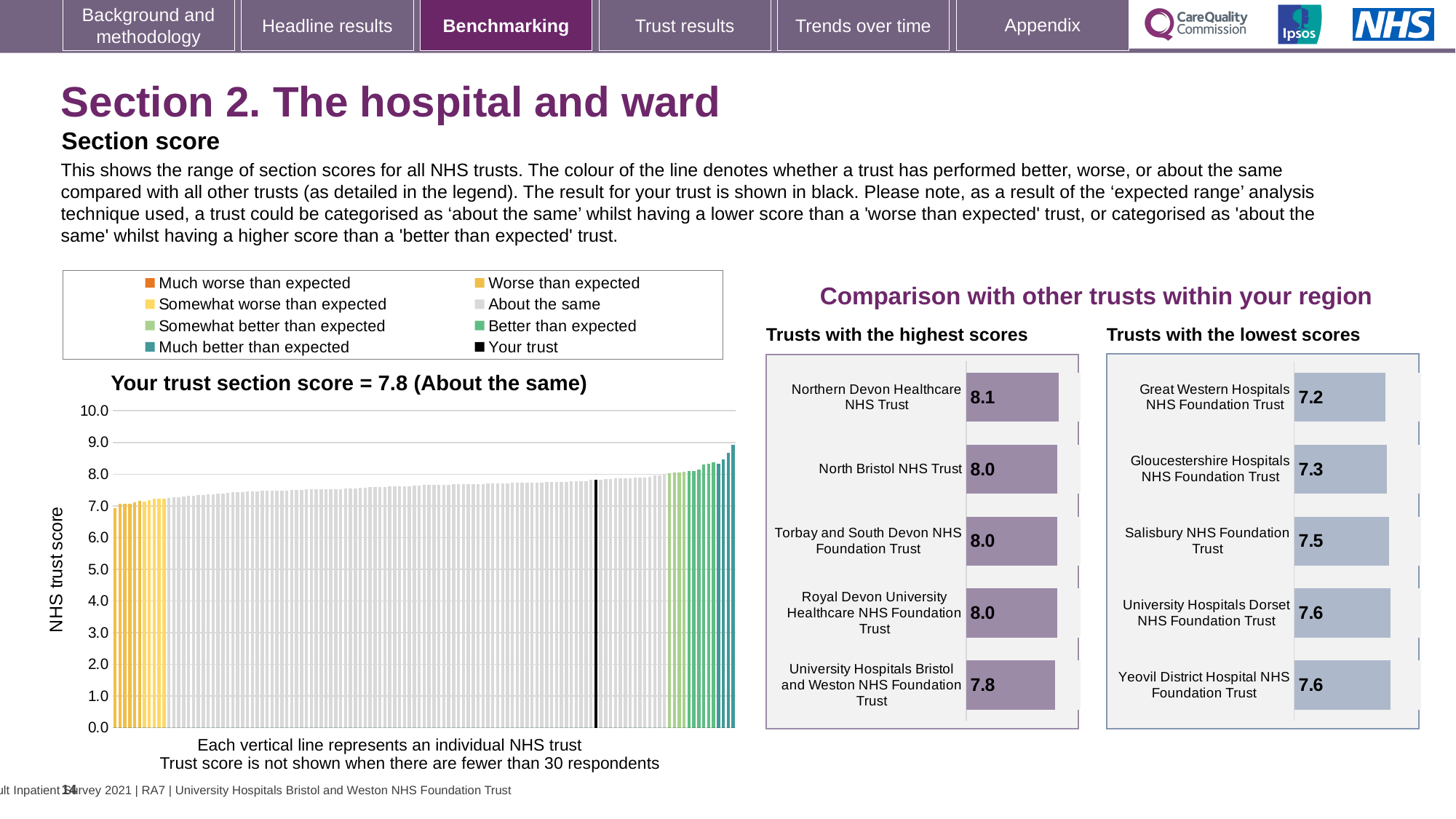
In the 'Trusts with the highest scores' chart, what is the score for Northern Devon Healthcare NHS Trust? 8.1 In the 'Trusts with the highest scores' chart, which trust has the highest score? Northern Devon Healthcare NHS Trust In the 'Trusts with the lowest scores' chart, what is the score for Salisbury NHS Foundation Trust? 7.5 In the 'Trusts with the highest scores' chart, how many trusts are listed? 5 In the 'Trusts with the lowest scores' chart, which has the larger score: Gloucestershire Hospitals NHS Foundation Trust or Salisbury NHS Foundation Trust? Salisbury NHS Foundation Trust In the 'Trusts with the lowest scores' chart, what is the score for Great Western Hospitals NHS Foundation Trust? 7.2 In the 'Trusts with the lowest scores' chart, which trust has the lowest score? Great Western Hospitals NHS Foundation Trust In the 'Trusts with the lowest scores' chart, what is the difference between the scores of Salisbury NHS Foundation Trust and Great Western Hospitals NHS Foundation Trust? 0.3 In the large chart on the left showing all NHS trusts, what is the section score for your trust as stated in the chart title? 7.8 In the large chart on the left showing all NHS trusts, do the values rise or fall from left to right along the x axis? rise In the 'Trusts with the highest scores' chart, what is the difference between the scores of Northern Devon Healthcare NHS Trust and University Hospitals Bristol and Weston NHS Foundation Trust? 0.3 In the 'Trusts with the highest scores' chart, what is the score for University Hospitals Bristol and Weston NHS Foundation Trust? 7.8